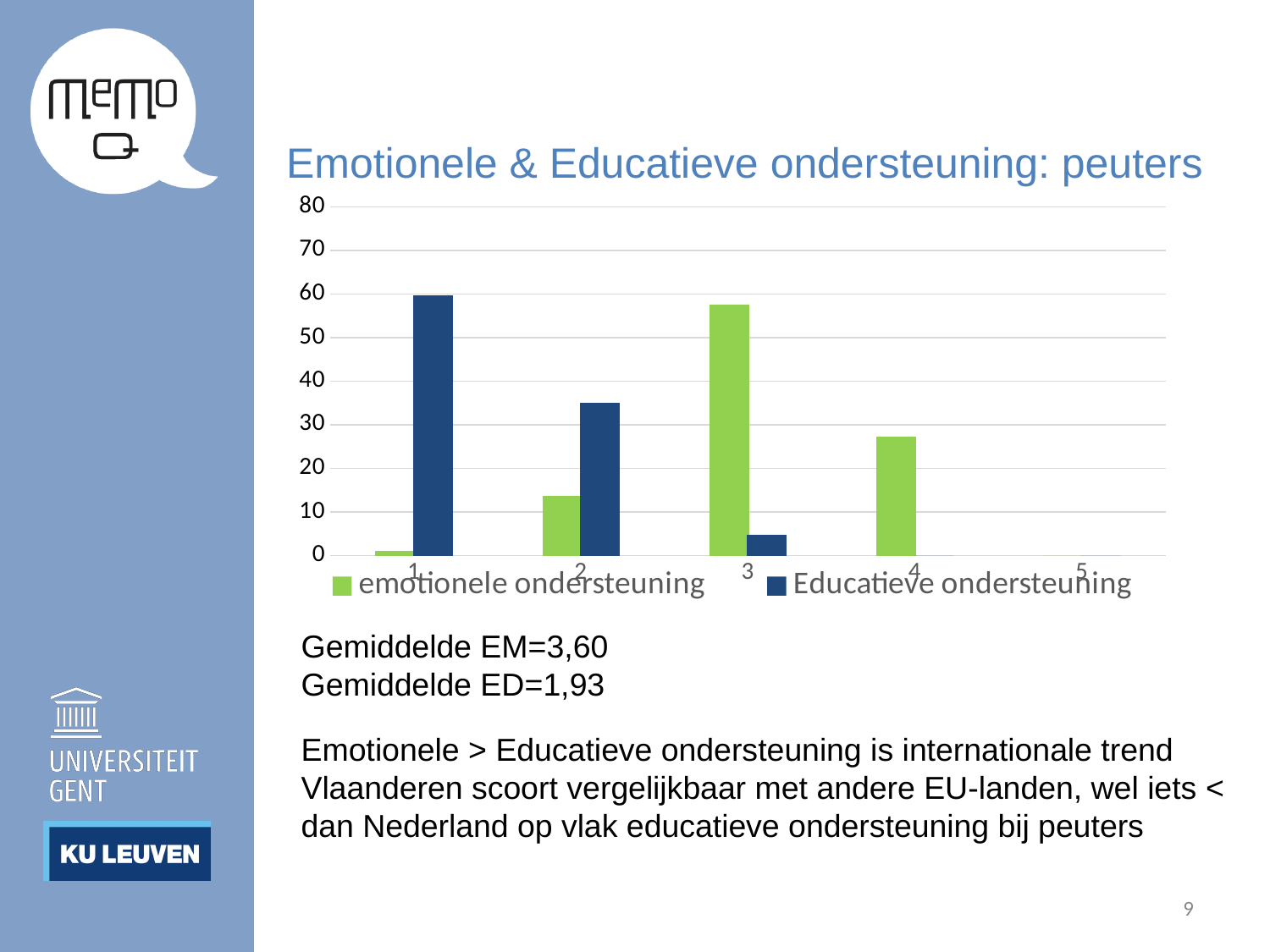
Is the value for Educatieve ondersteuning in category 3 greater or less than 10? less Which category has the highest value for Educatieve ondersteuning? 1 Is the value for Educatieve ondersteuning in category 1 greater or less than 50? greater What kind of chart is shown on the slide? bar chart In category 2, which series has the larger value: emotionele ondersteuning or Educatieve ondersteuning? Educatieve ondersteuning Is the value for emotionele ondersteuning in category 4 greater or less than 20? greater In category 3, which series has the larger value: emotionele ondersteuning or Educatieve ondersteuning? emotionele ondersteuning How many categories are shown on the x axis? 5 Which category has the highest value for emotionele ondersteuning? 3 What is the title of the chart? Emotionele & Educatieve ondersteuning: peuters How many series does the legend list? 2